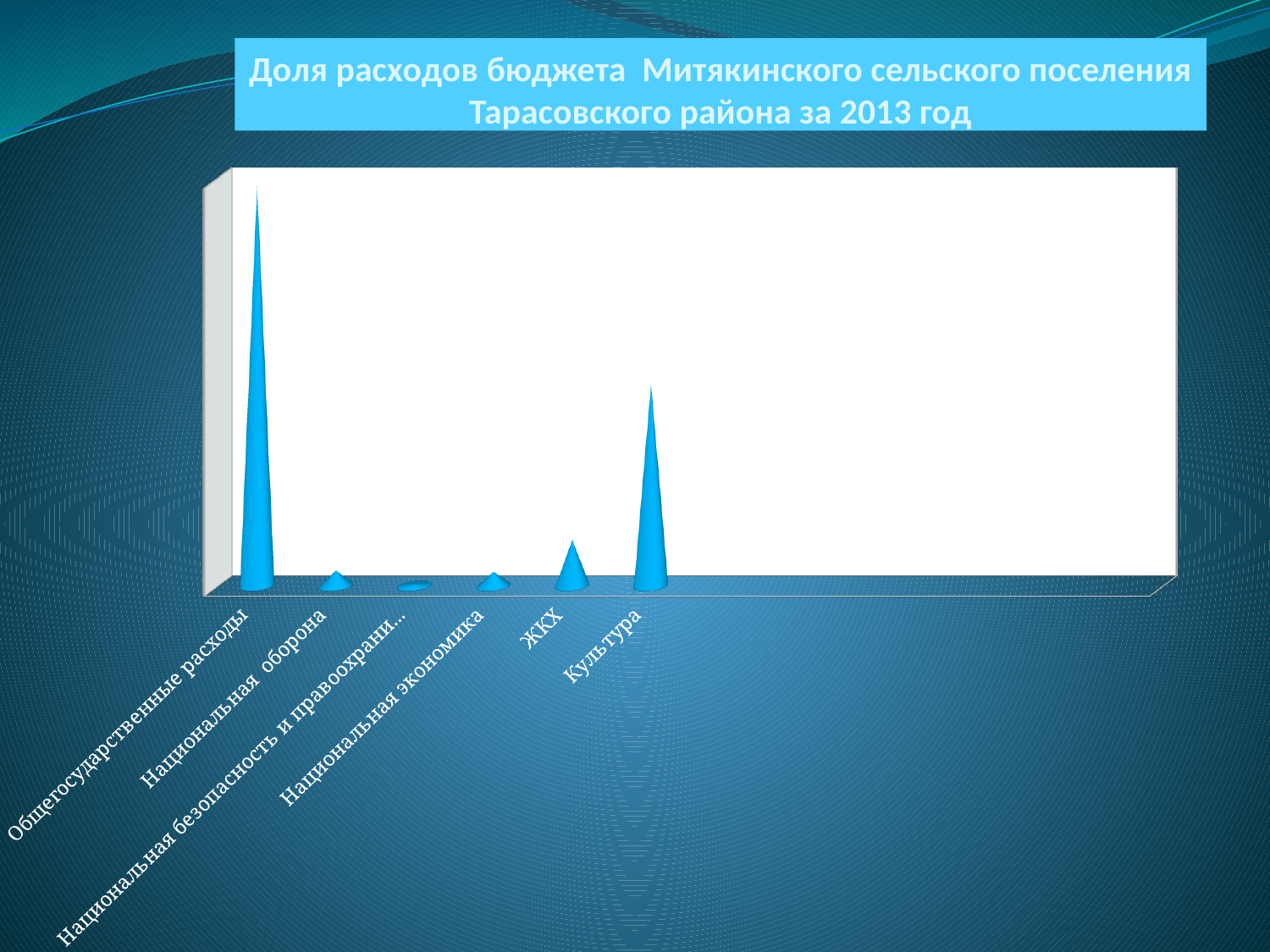
Which category has the lowest value in the chart? Национальная безопасность и правоохрани... What kind of chart is shown on the slide? bar chart Which is larger, the value for Общегосударственные расходы or the value for Культура? Общегосударственные расходы Which is larger, the value for ЖКХ or the value for Национальная оборона? ЖКХ Which is larger, the value for Культура or the value for ЖКХ? Культура Which category has the highest value in the chart? Общегосударственные расходы How many categories are shown on the x axis of the chart? 6 Which category has the second highest value in the chart? Культура What is the title of the chart on the slide? Доля расходов бюджета Митякинского сельского поселения Тарасовского района за 2013 год What colour are the bars in the chart? blue